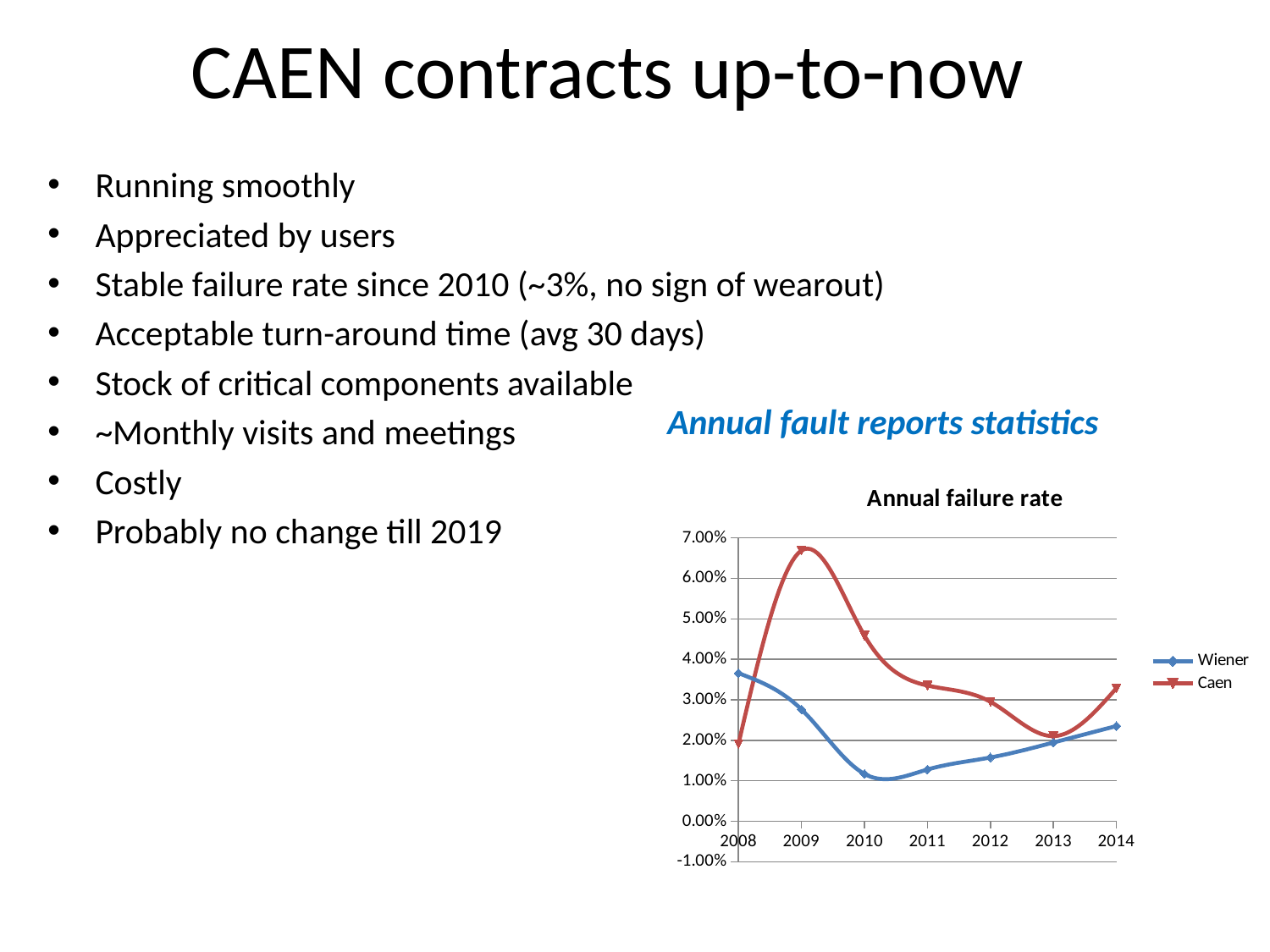
Is the Wiener failure rate in 2010 greater or less than 2.00%? less What is the title of the chart? Annual failure rate How many years are plotted along the x axis of the chart? 7 In which year does the Wiener series have its highest failure rate? 2008 What kind of chart is shown on the slide? Line chart In which year does the Caen series reach its highest failure rate? 2009 Is the Caen failure rate in 2010 greater or less than 4.00%? greater How many series does the legend of the chart list? 2 Is the Caen failure rate in 2009 greater or less than 6.00%? greater Does the Caen failure rate rise or fall from 2009 to 2013? fall Which series has the higher failure rate in 2014, Wiener or Caen? Caen Which series has the higher failure rate in 2008, Wiener or Caen? Wiener